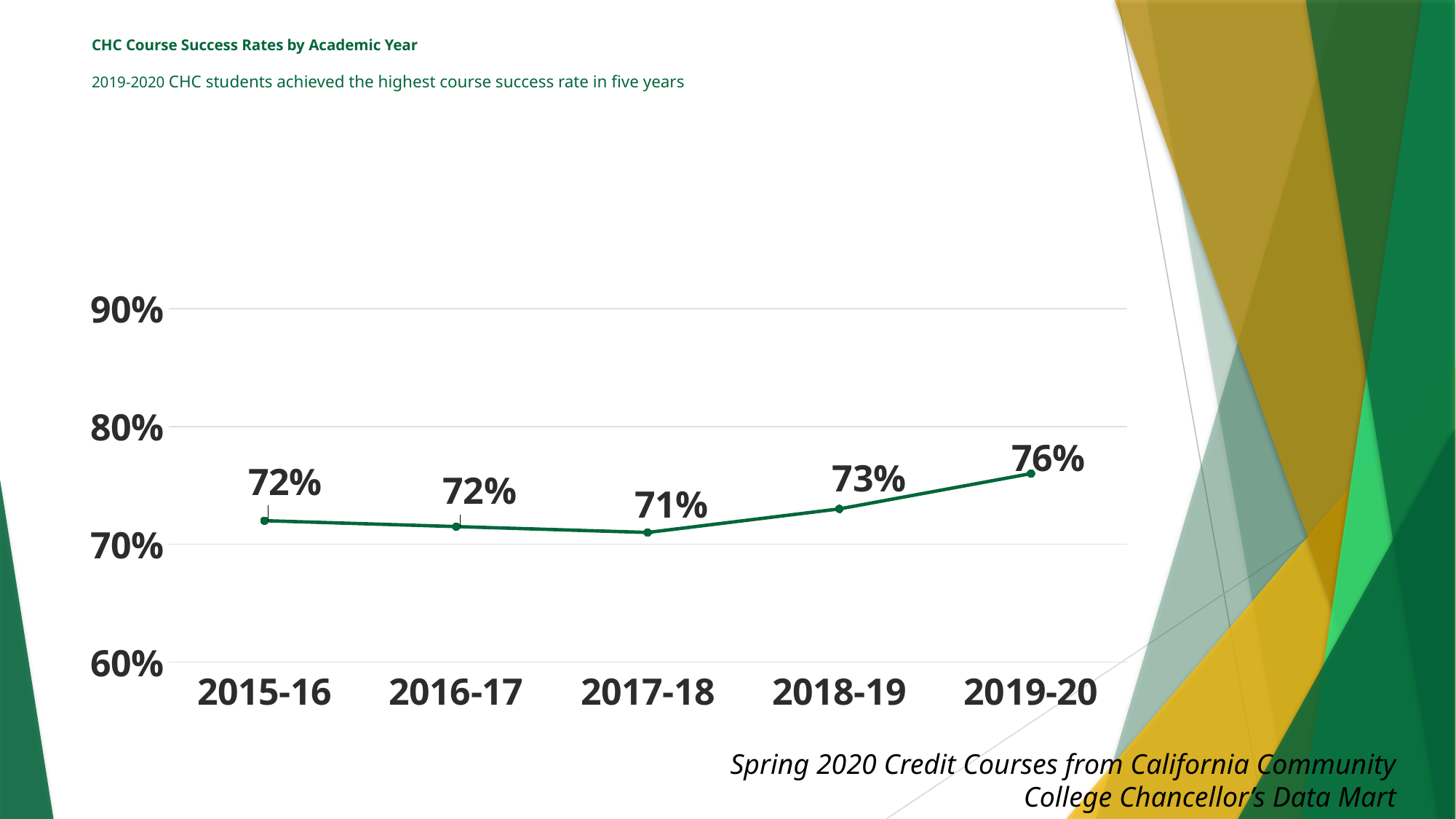
What is the difference between the course success rates for 2019-20 and 2017-18? 5% How many academic years are plotted on the chart? 5 What is the course success rate for 2018-19? 73% Does the course success rate rise or fall from 2017-18 to 2019-20? rise What is the course success rate for 2017-18? 71% What is the course success rate for 2015-16? 72% Which has a higher course success rate, 2018-19 or 2019-20? 2019-20 What kind of chart is shown on the slide? line chart Which academic year has the highest course success rate? 2019-20 Which academic year has the lowest course success rate? 2017-18 What is the course success rate for 2019-20? 76% Is the course success rate for 2019-20 greater or less than 80%? less